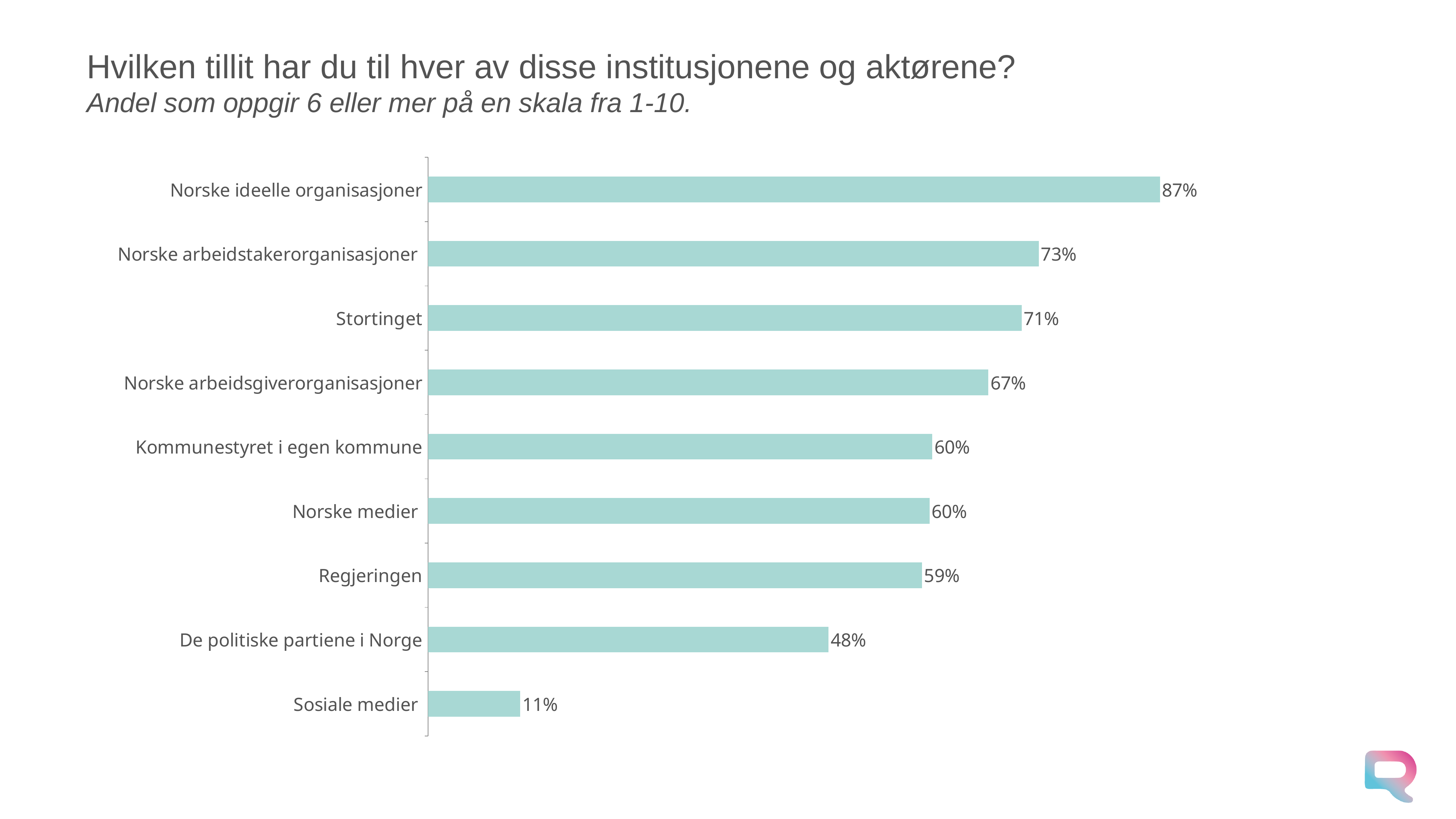
What is the difference between the values for Regjeringen and Sosiale medier? 48% Which category has the lowest value? Sosiale medier Which is larger, the value for Stortinget or the value for Regjeringen? Stortinget What is the value for De politiske partiene i Norge? 48% What is the subtitle shown under the chart title? Andel som oppgir 6 eller mer på en skala fra 1-10. What is the difference between the values for Norske ideelle organisasjoner and Norske arbeidstakerorganisasjoner? 14% What is the value for Norske arbeidsgiverorganisasjoner? 67% How many categories are shown in the chart? 9 Which category has the highest value? Norske ideelle organisasjoner What kind of chart is shown on the slide? Bar chart What is the value for Stortinget? 71% What is the value for Sosiale medier? 11%